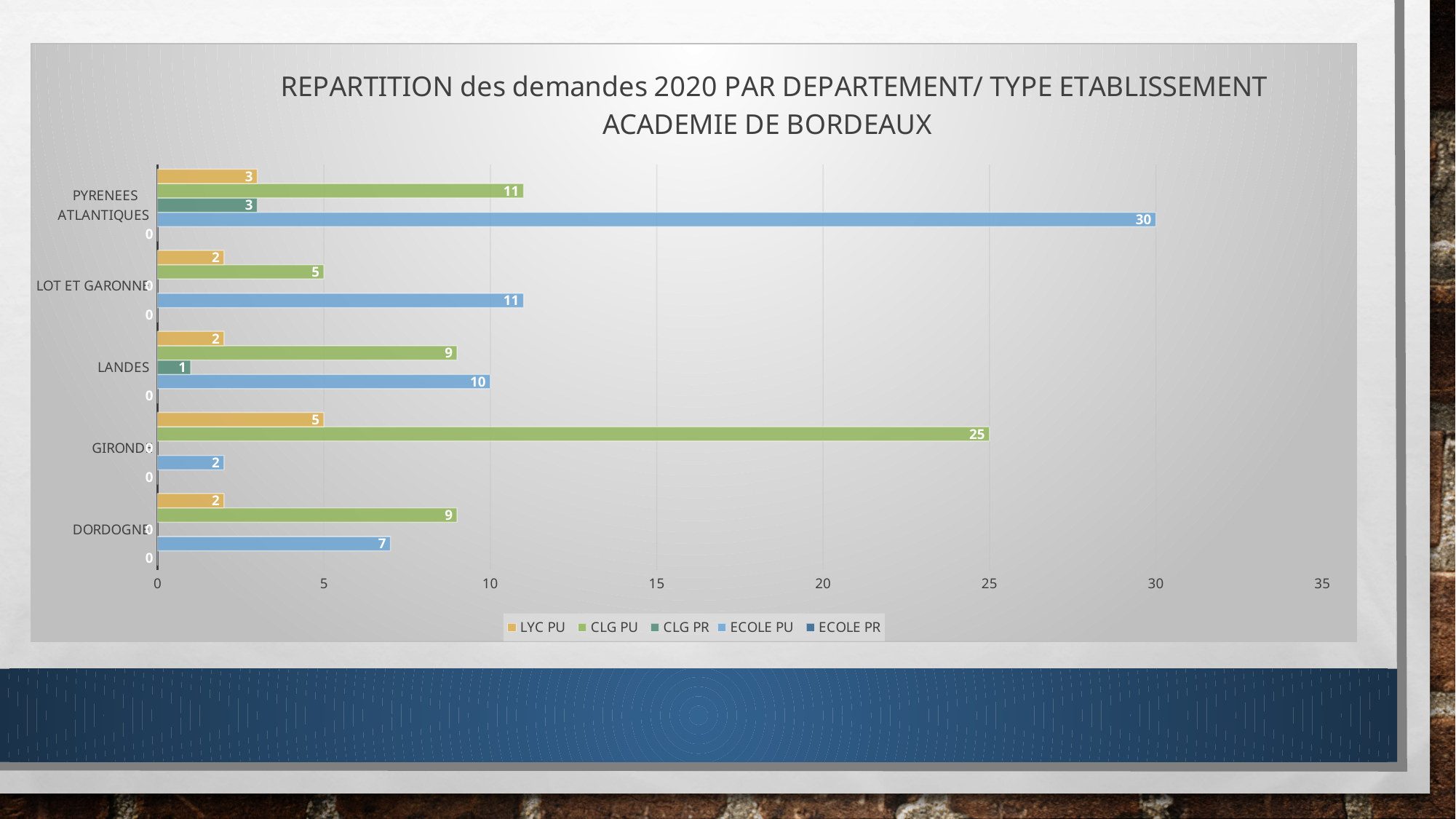
How many series does the legend list? 5 What is the ECOLE PU value for DORDOGNE? 7 What is the difference between the CLG PU values for GIRONDE and PYRENEES ATLANTIQUES? 14 What is the CLG PR value for LANDES? 1 Which is larger: the ECOLE PU value for LANDES or the ECOLE PU value for LOT ET GARONNE? LOT ET GARONNE What is the ECOLE PU value for PYRENEES ATLANTIQUES? 30 What is the CLG PU value for GIRONDE? 25 How many departments (categories) are shown on the chart? 5 Which department has the lowest ECOLE PU value? GIRONDE What type of chart is shown on the slide? bar chart What is the ECOLE PR value for every department on the chart? 0 Which department has the highest ECOLE PU value? PYRENEES ATLANTIQUES